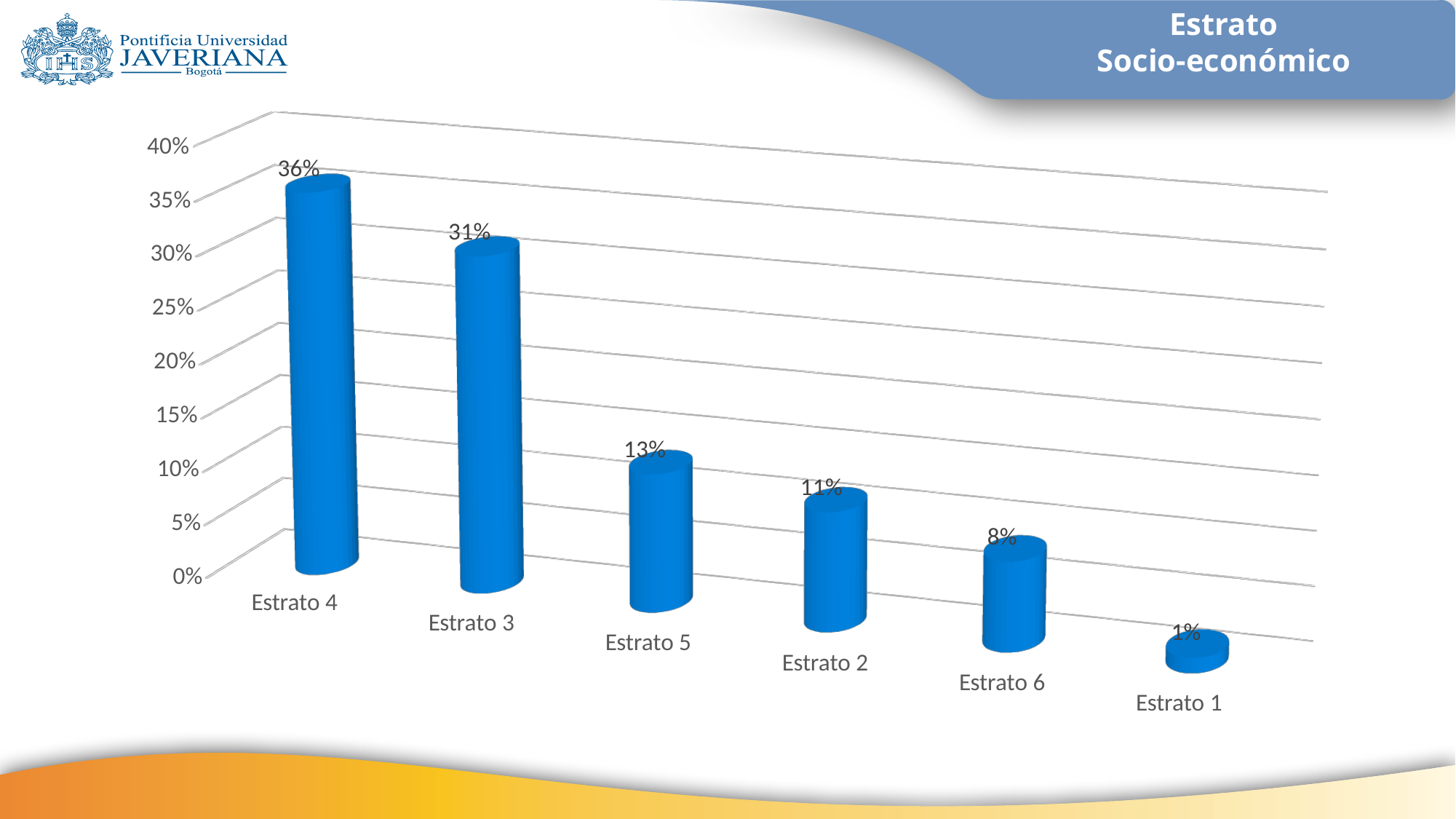
Do the values rise or fall from left to right along the x axis? Fall What is the value for Estrato 3? 31% What is the value for Estrato 6? 8% What is the value for Estrato 4? 36% What is the value for Estrato 5? 13% Which is larger, the value for Estrato 2 or the value for Estrato 6? Estrato 2 Which category has the highest value? Estrato 4 What kind of chart is shown on the slide? Bar chart What is the difference between the values for Estrato 4 and Estrato 3? 5% Which category has the lowest value? Estrato 1 Is the value for Estrato 5 greater or less than 10%? greater How many categories are shown in the chart? 6